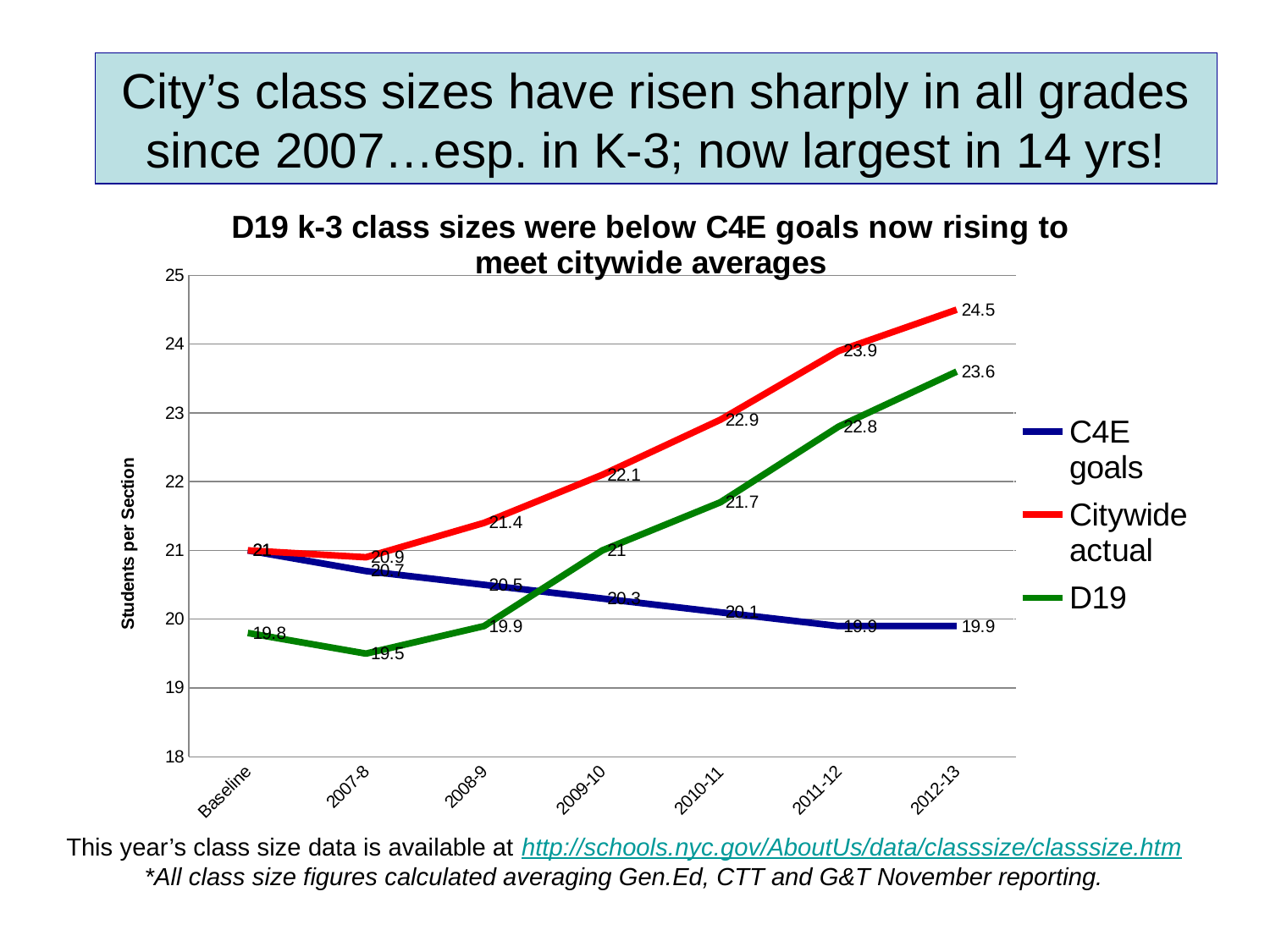
Does the C4E goals series rise or fall from Baseline to 2012-13? Fall How many series does the legend list? 3 What kind of chart is shown? Line chart In which year is the Citywide actual value highest? 2012-13 What is the D19 value for 2012-13? 23.6 In 2011-12, which is larger: Citywide actual or D19? Citywide actual What is the D19 value for 2007-8? 19.5 How many points are plotted along the x axis for each series? 7 What is the difference between the Citywide actual and D19 values in 2012-13? 0.9 What is the Citywide actual value for 2010-11? 22.9 In which year is the D19 value lowest? 2007-8 What is the Citywide actual value for 2012-13? 24.5